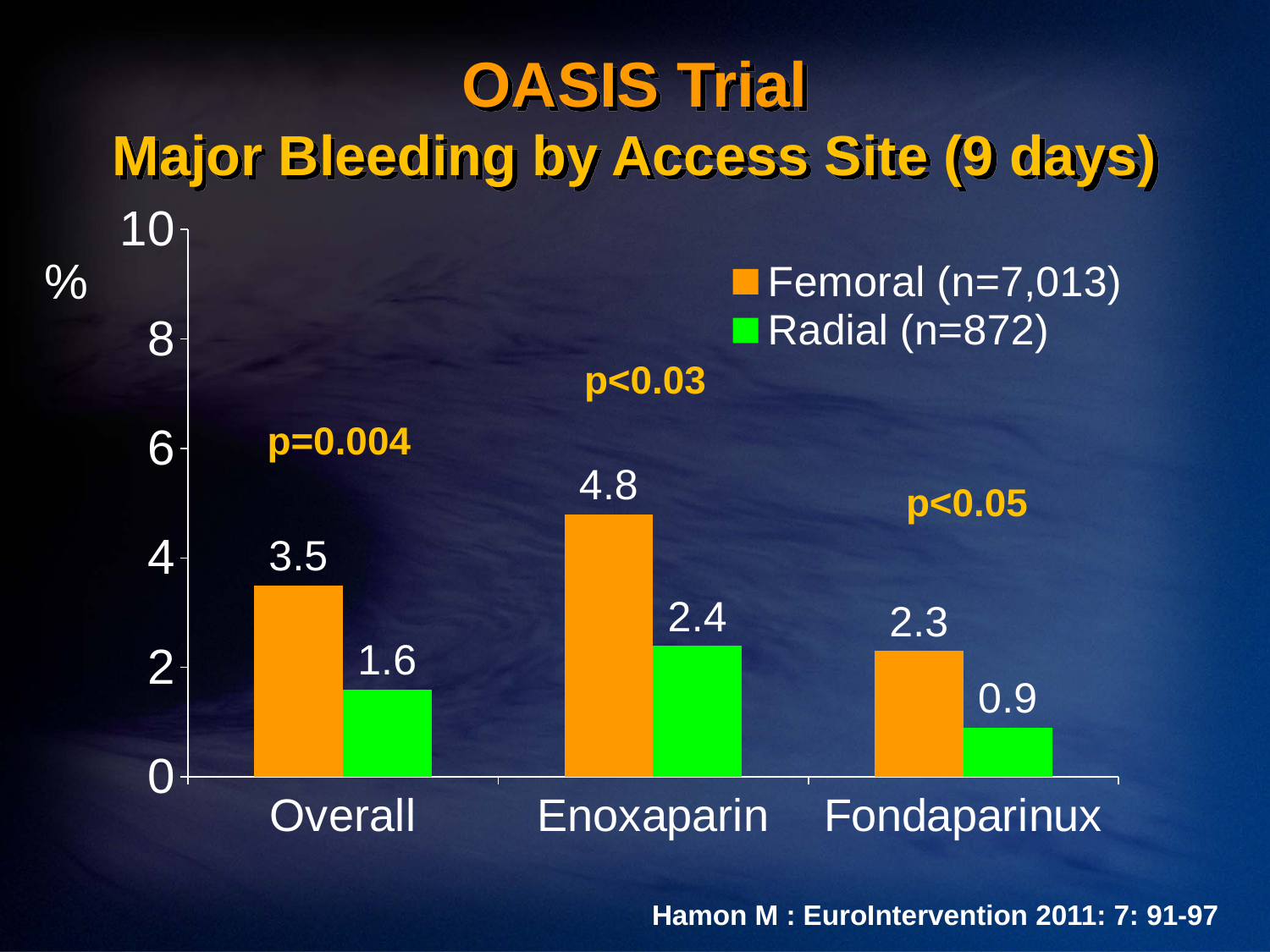
What is the Radial value for Fondaparinux? 0.9 Which category has the highest Femoral value? Enoxaparin What is the difference between the Femoral and Radial values for Overall? 1.9 Which category has the lowest Radial value? Fondaparinux How many series does the legend list? 2 What is the Femoral value for Overall? 3.5 What is the Radial value for Enoxaparin? 2.4 What p-value is shown above the Overall bars? p=0.004 Which is larger, the Femoral value for Fondaparinux or the Radial value for Enoxaparin? Radial value for Enoxaparin How many categories are shown on the x axis? 3 What kind of chart is shown on the slide? Bar chart What is the Femoral value for Enoxaparin? 4.8